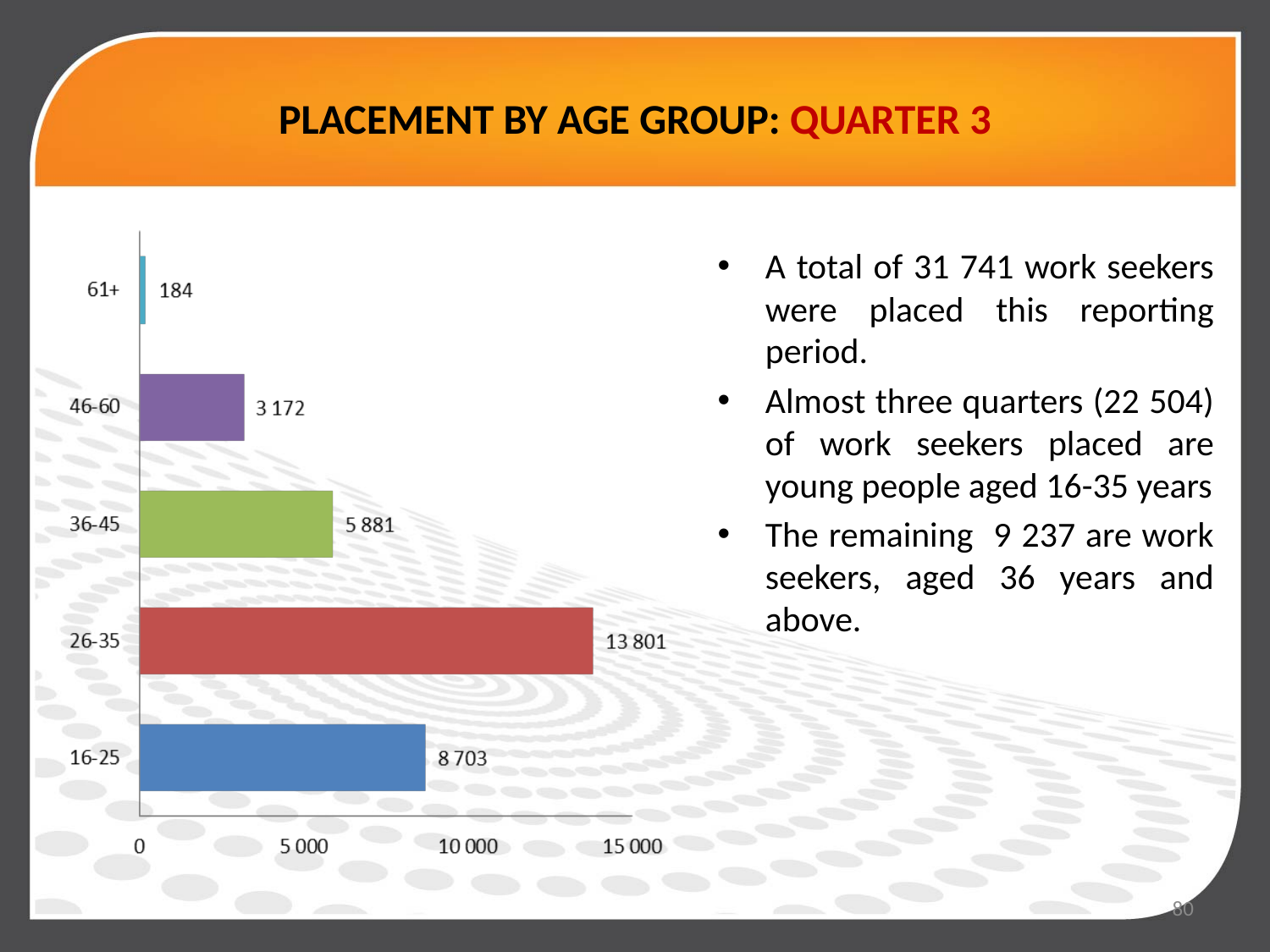
What is the difference in placements between the 26-35 and 16-25 age groups? 5 098 Which age group has the highest number of placements? 26-35 What is the number of placements for the 61+ age group? 184 What is the number of placements for the 36-45 age group? 5 881 What kind of chart is shown on the slide? Bar chart What is the title of the slide containing the chart? PLACEMENT BY AGE GROUP: QUARTER 3 Which age group has more placements, 16-25 or 36-45? 16-25 Which age group has the lowest number of placements? 61+ Is the value for the 26-35 age group greater or less than 10 000? greater What is the number of placements for the 26-35 age group? 13 801 How many age groups are shown in the chart? 5 What is the difference in placements between the 36-45 and 46-60 age groups? 2 709